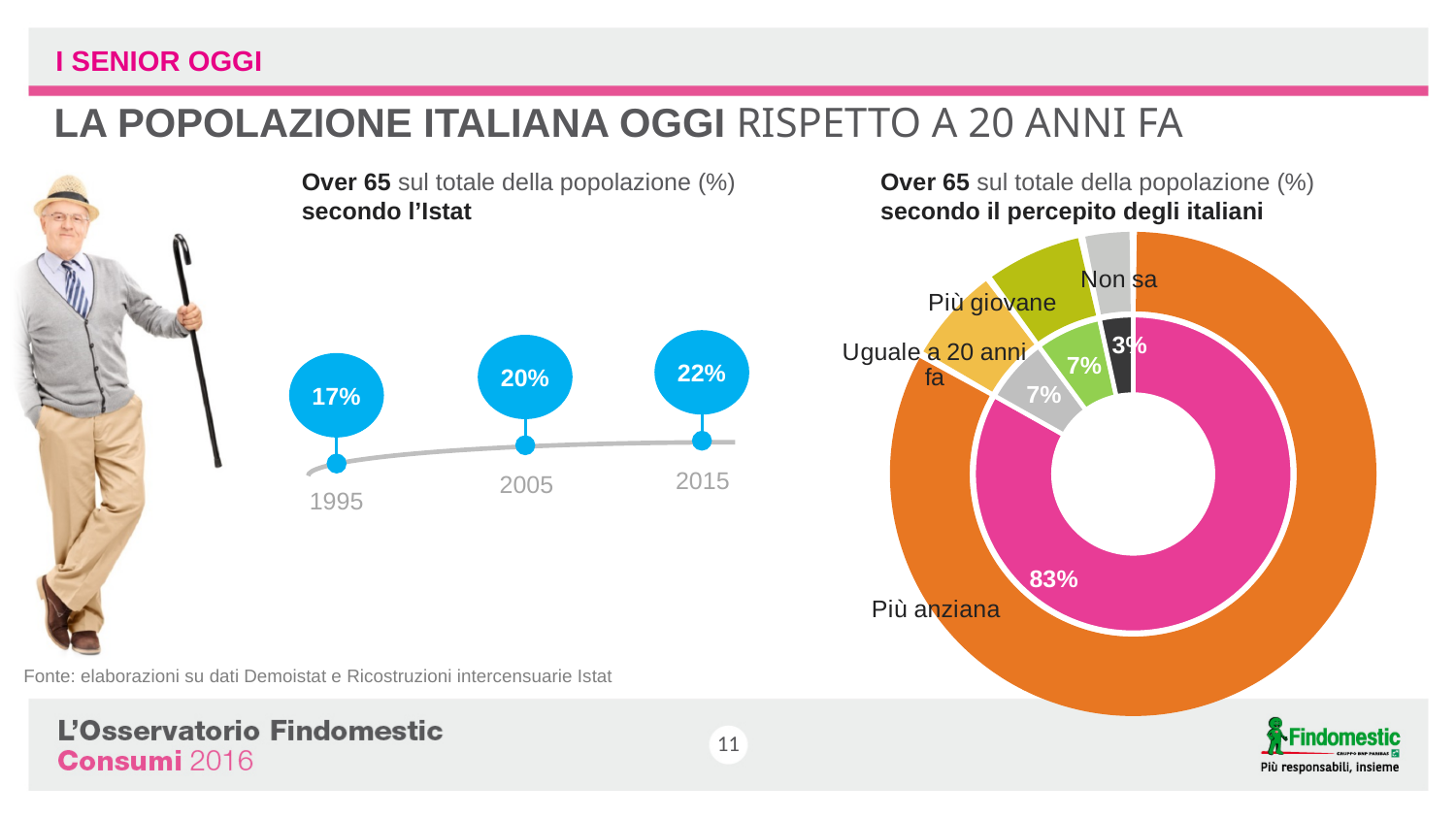
In the right chart (secondo il percepito degli italiani), which category has the smallest share? Non sa How many categories are shown in the right chart (secondo il percepito degli italiani)? 4 In the right chart (secondo il percepito degli italiani), what share is labelled 'Non sa'? 3% In the left chart (Over 65 secondo l'Istat), what is the value for 2015? 22% In the right chart (secondo il percepito degli italiani), which category has the largest share? Più anziana In the left chart (Over 65 secondo l'Istat), what is the value for 2005? 20% What kind of chart is the right chart (secondo il percepito degli italiani)? donut (pie) chart In the right chart (secondo il percepito degli italiani), what share is labelled 'Più anziana'? 83% In the left chart (Over 65 secondo l'Istat), what is the value for 1995? 17% In the left chart (Over 65 secondo l'Istat), what is the difference between the 2015 and 1995 values? 5 percentage points How many years are plotted in the left chart (Over 65 secondo l'Istat)? 3 In the left chart (Over 65 secondo l'Istat), do the values rise or fall from 1995 to 2015? rise